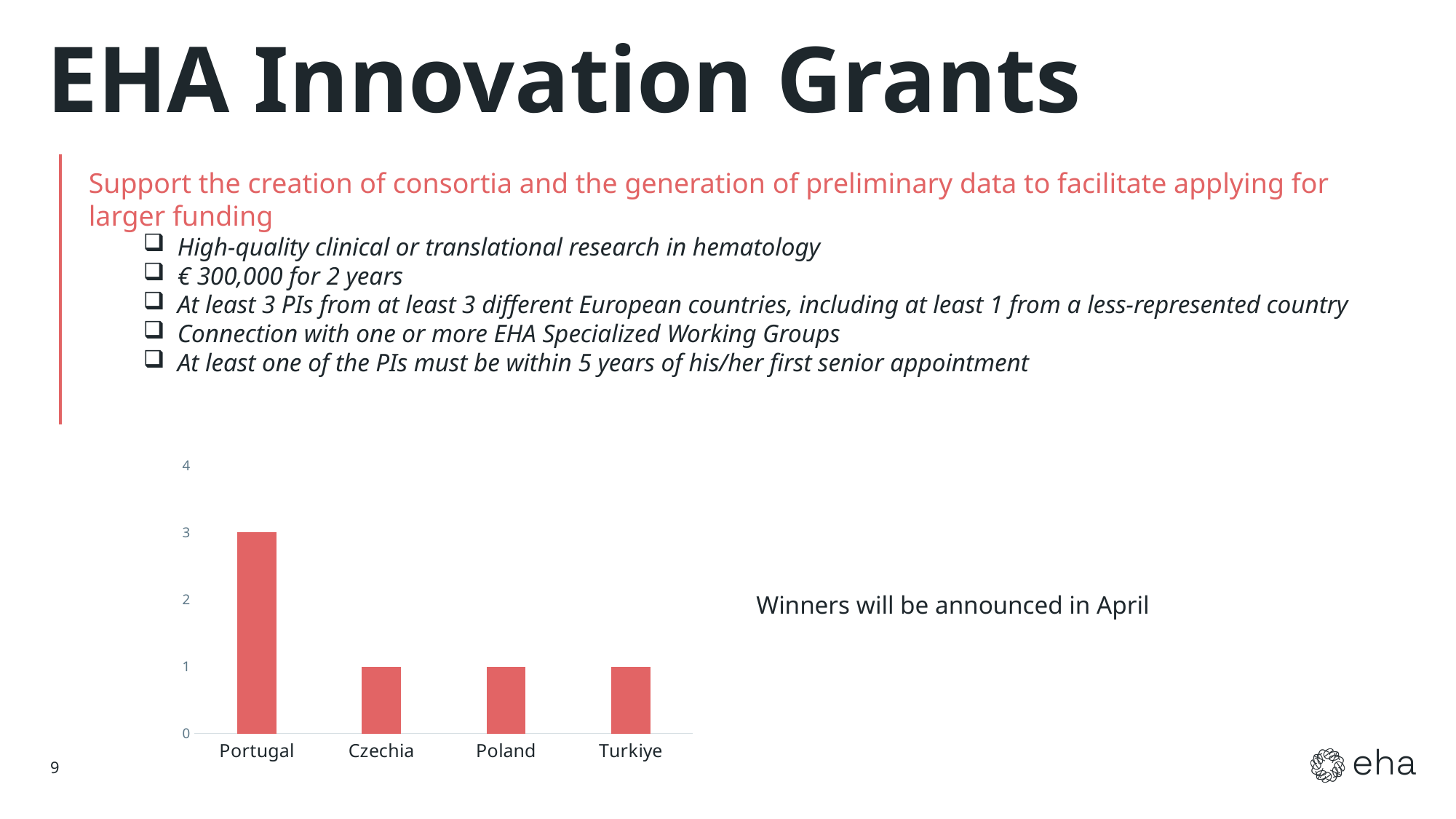
What kind of chart is shown on the slide? bar chart Is the value for Turkiye greater or less than 2? less Which country has the highest value? Portugal How many countries are shown on the chart? 4 What is the value for Czechia? 1 What is the value for Turkiye? 1 Is the value for Portugal greater or less than 2? greater What is the value for Poland? 1 What is the difference between the values for Portugal and Czechia? 2 What is the value for Portugal? 3 Which is larger, the value for Portugal or the value for Poland? Portugal What is the maximum value shown on the vertical axis? 4